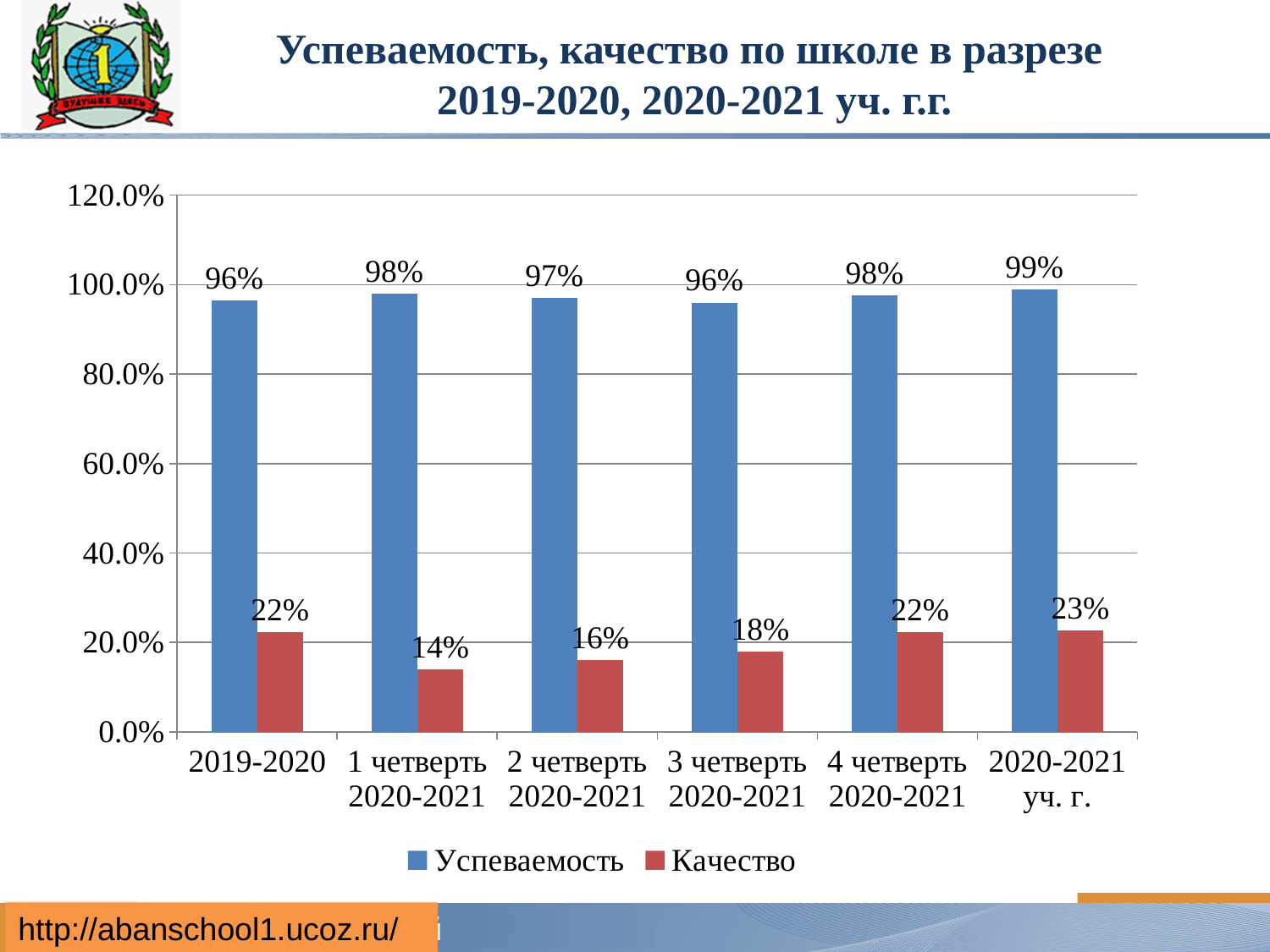
Do the Качество values rise or fall across the four quarters of 2020-2021? rise What is the Качество value for 1 четверть 2020-2021? 14% Is the Качество value for 3 четверть 2020-2021 greater or less than 20.0%? less How many categories are shown on the x axis? 6 How many series does the legend list? 2 What kind of chart is shown on the slide? bar chart Which category has the lowest Качество value? 1 четверть 2020-2021 Which category has the highest Успеваемость value? 2020-2021 уч. г. Which is larger: the Качество value for 2 четверть 2020-2021 or for 4 четверть 2020-2021? 4 четверть 2020-2021 What is the difference between the Качество values for 2020-2021 уч. г. and 1 четверть 2020-2021? 9% What is the Успеваемость value for 2019-2020? 96% What is the Качество value for 2020-2021 уч. г.? 23%